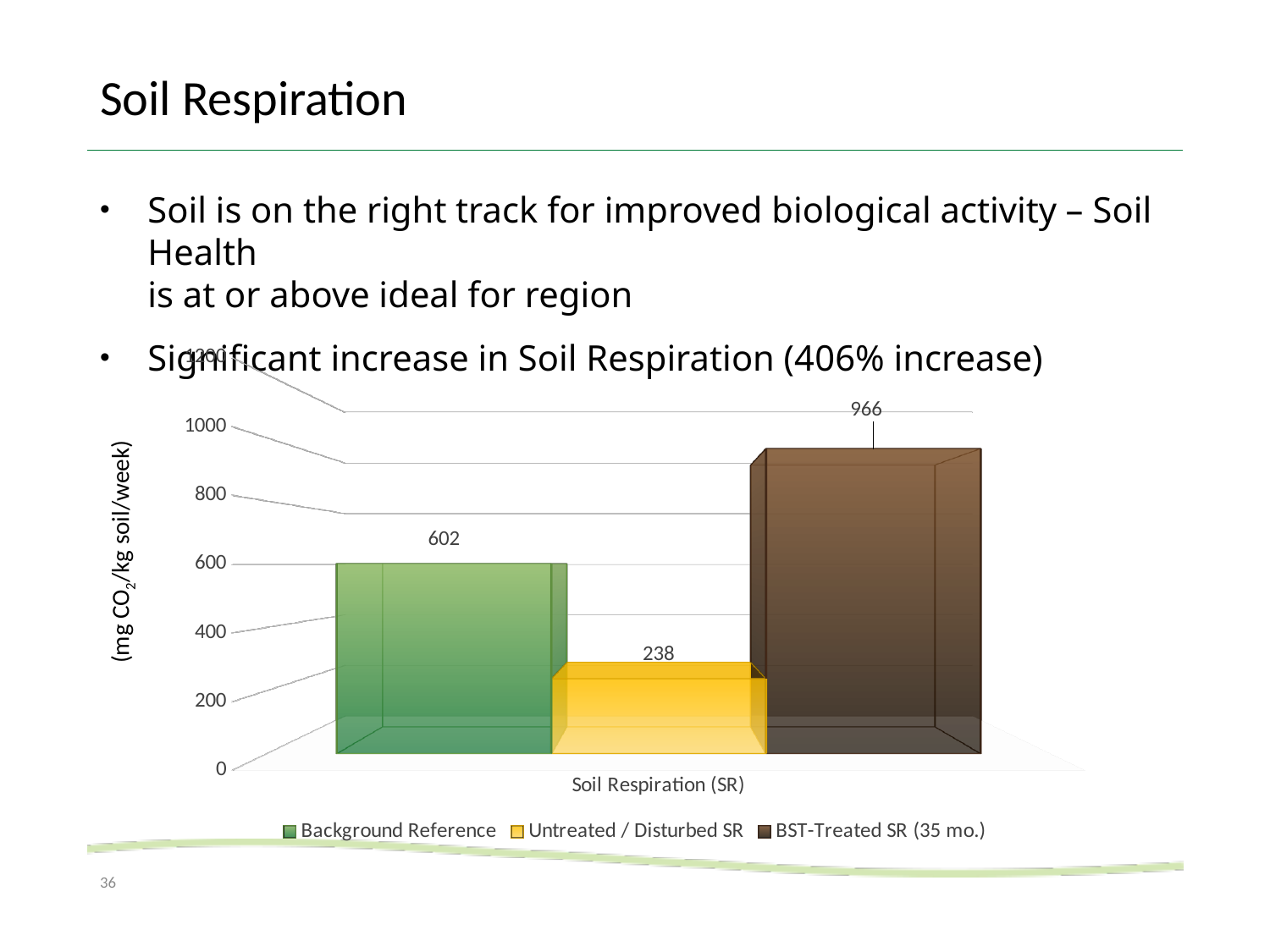
Which is larger, the value for Background Reference or the value for BST-Treated SR (35 mo.)? BST-Treated SR (35 mo.) Which series has the lowest value? Untreated / Disturbed SR What is the value for Background Reference? 602 What is the value for BST-Treated SR (35 mo.)? 966 Is the value for Untreated / Disturbed SR greater or less than 400? less What is the difference between the BST-Treated SR (35 mo.) value and the Untreated / Disturbed SR value? 728 What is the category label on the x axis of the chart? Soil Respiration (SR) What is the difference between the Background Reference value and the Untreated / Disturbed SR value? 364 Which series has the highest value? BST-Treated SR (35 mo.) What kind of chart is shown on the slide? bar chart What is the value for Untreated / Disturbed SR? 238 How many series does the legend list? 3